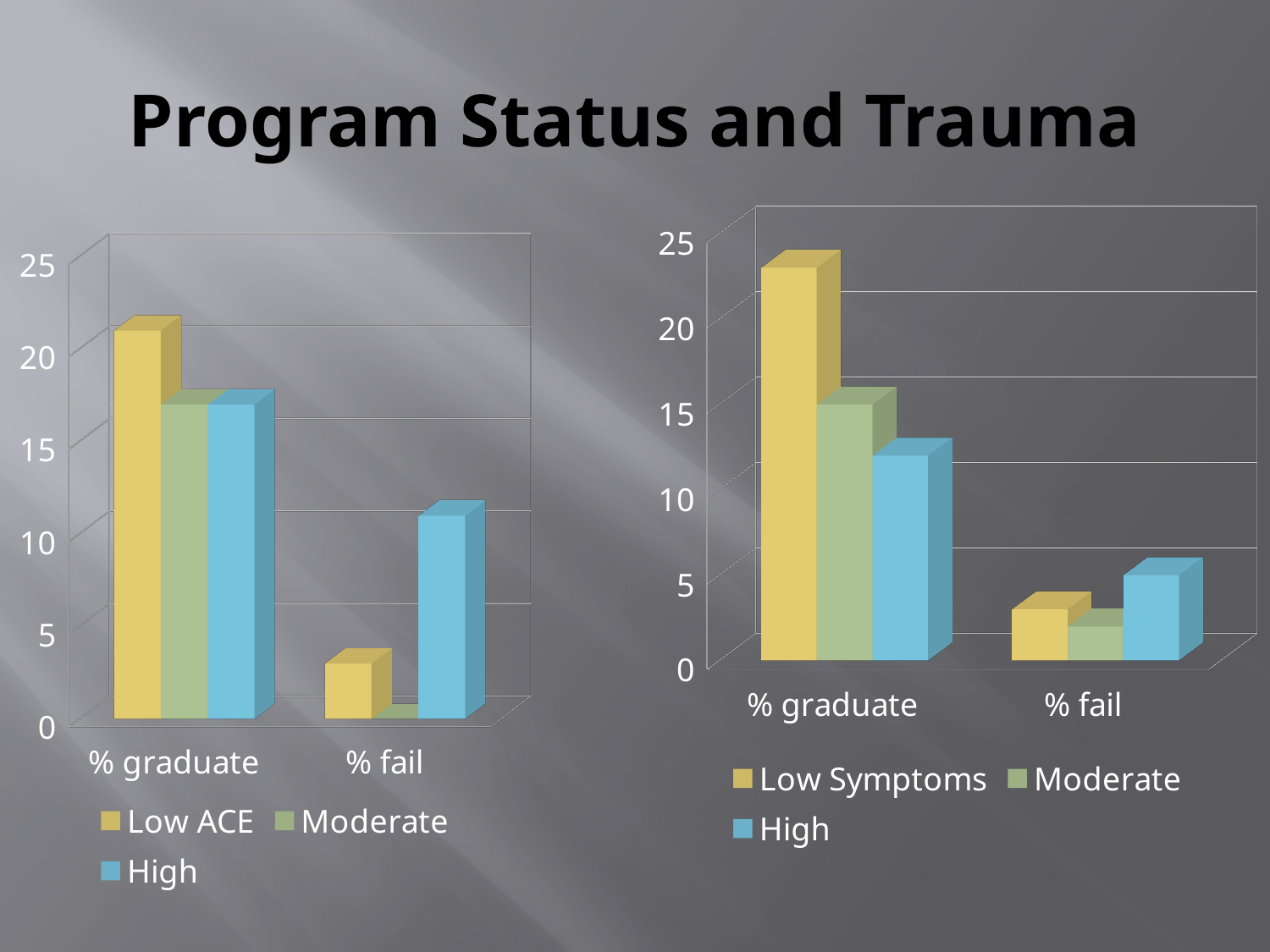
On the right chart, what are the three legend entries? Low Symptoms, Moderate, High On the right chart, is the High value for % graduate greater or less than 15? less On the right chart, which is larger for % fail: High or Moderate? High On the left chart, which series has the highest value for % graduate? Low ACE On the left chart, is the High value for % fail greater or less than 10? greater On the left chart, how many categories are shown on the x axis? 2 On the right chart, which series has the highest value for % graduate? Low Symptoms What kind of chart is the left chart? bar chart On the left chart, which series has the lowest value for % fail? Moderate On the left chart, how many series does the legend list? 3 On the right chart, is the Low Symptoms value for % graduate greater or less than 20? greater